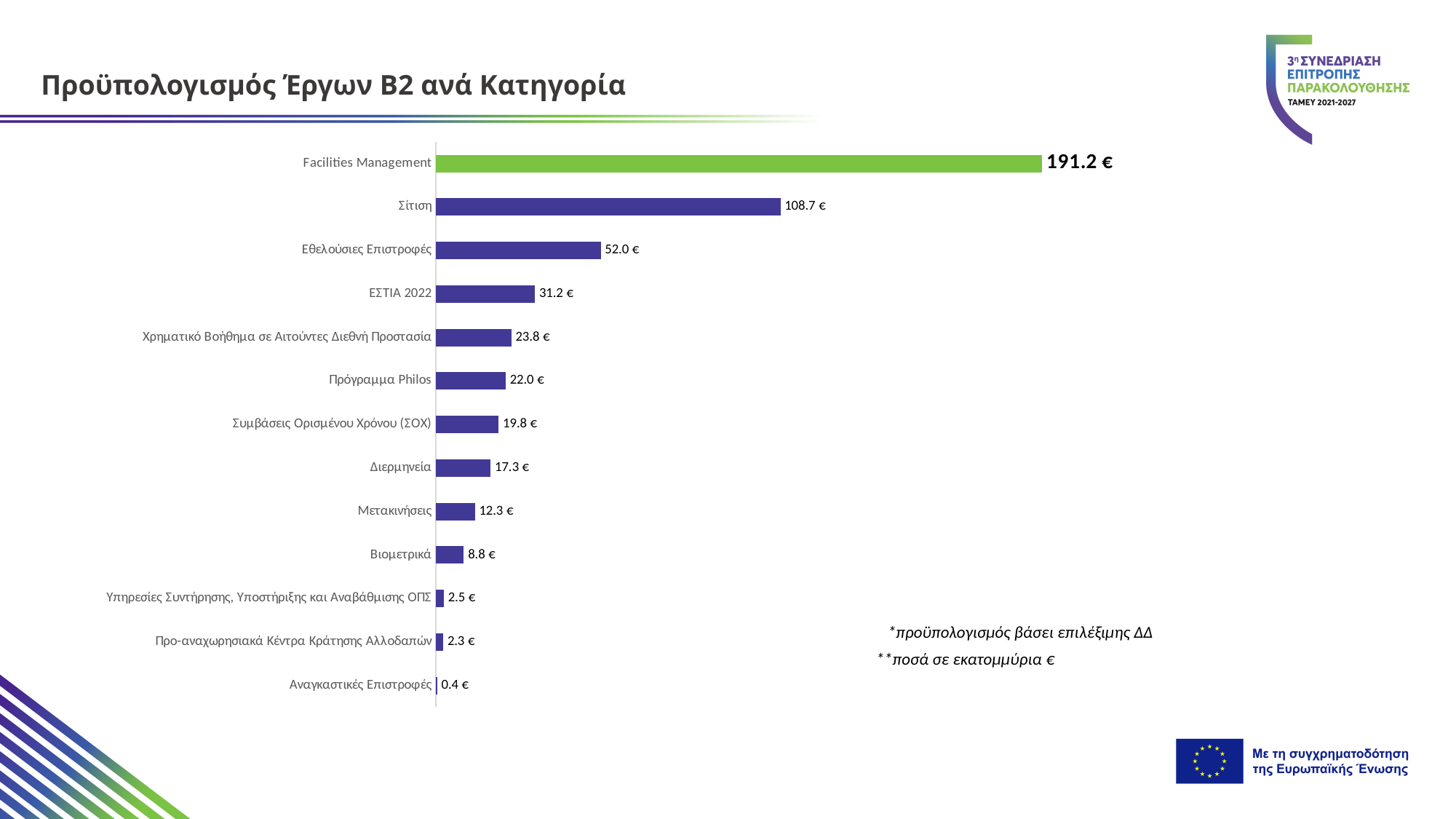
How many categories are shown in the chart? 13 What is the value for Σίτιση? 108.7 € What kind of chart is shown on the slide? Bar chart What is the difference between the values for Εθελούσιες Επιστροφές and ΕΣΤΙΑ 2022? 20.8 € Which is larger, the value for Πρόγραμμα Philos or for Συμβάσεις Ορισμένου Χρόνου (ΣΟΧ)? Πρόγραμμα Philos What is the value for Facilities Management? 191.2 € What is the title of the slide? Προϋπολογισμός Έργων Β2 ανά Κατηγορία What is the value for Βιομετρικά? 8.8 € Which category has the lowest value? Αναγκαστικές Επιστροφές What is the value for Διερμηνεία? 17.3 € Which category has the highest value? Facilities Management What is the difference between the values for Facilities Management and Σίτιση? 82.5 €